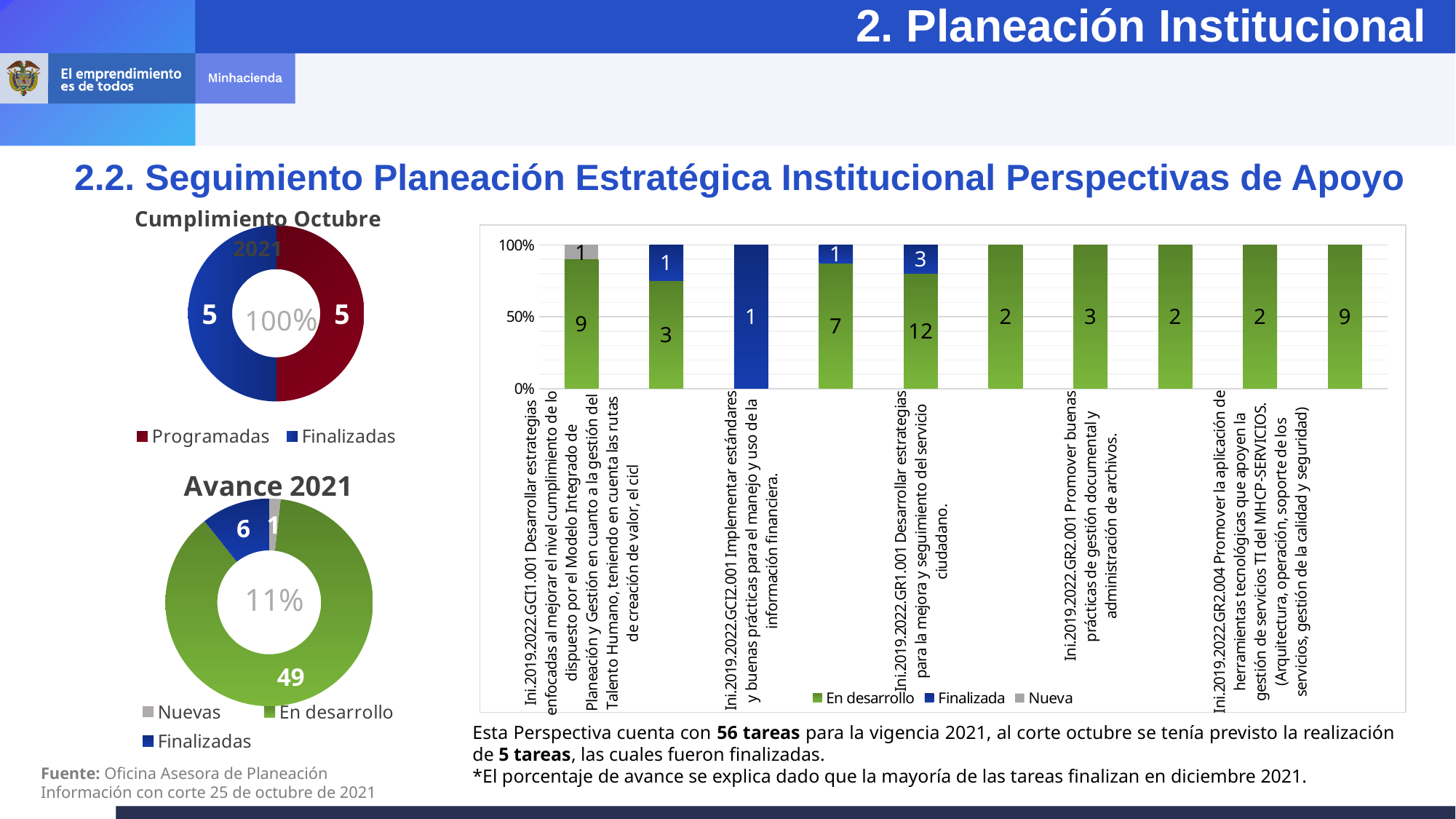
In the 'Cumplimiento Octubre 2021' chart, what is the value for Programadas? 5 In the 'Avance 2021' chart, which category has the smallest value? Nuevas In the 'Avance 2021' chart, how many categories does the legend list? 3 What kind of chart is the 'Avance 2021' chart? Donut chart In the 'Avance 2021' chart, what is the value for En desarrollo? 49 In the 'Avance 2021' chart, what is the difference between En desarrollo and Finalizadas? 43 In the 'Avance 2021' chart, what is the value for Finalizadas? 6 In the stacked bar chart on the right, what is the total number of tasks for Ini.2019.2022.GR1.001? 15 In the stacked bar chart on the right, what is the En desarrollo value for Ini.2019.2022.GR1.001? 12 In the 'Cumplimiento Octubre 2021' chart, what percentage is shown in the centre of the donut? 100% In the stacked bar chart on the right, how many bars are plotted? 10 In the stacked bar chart on the right, how many series does the legend list? 3